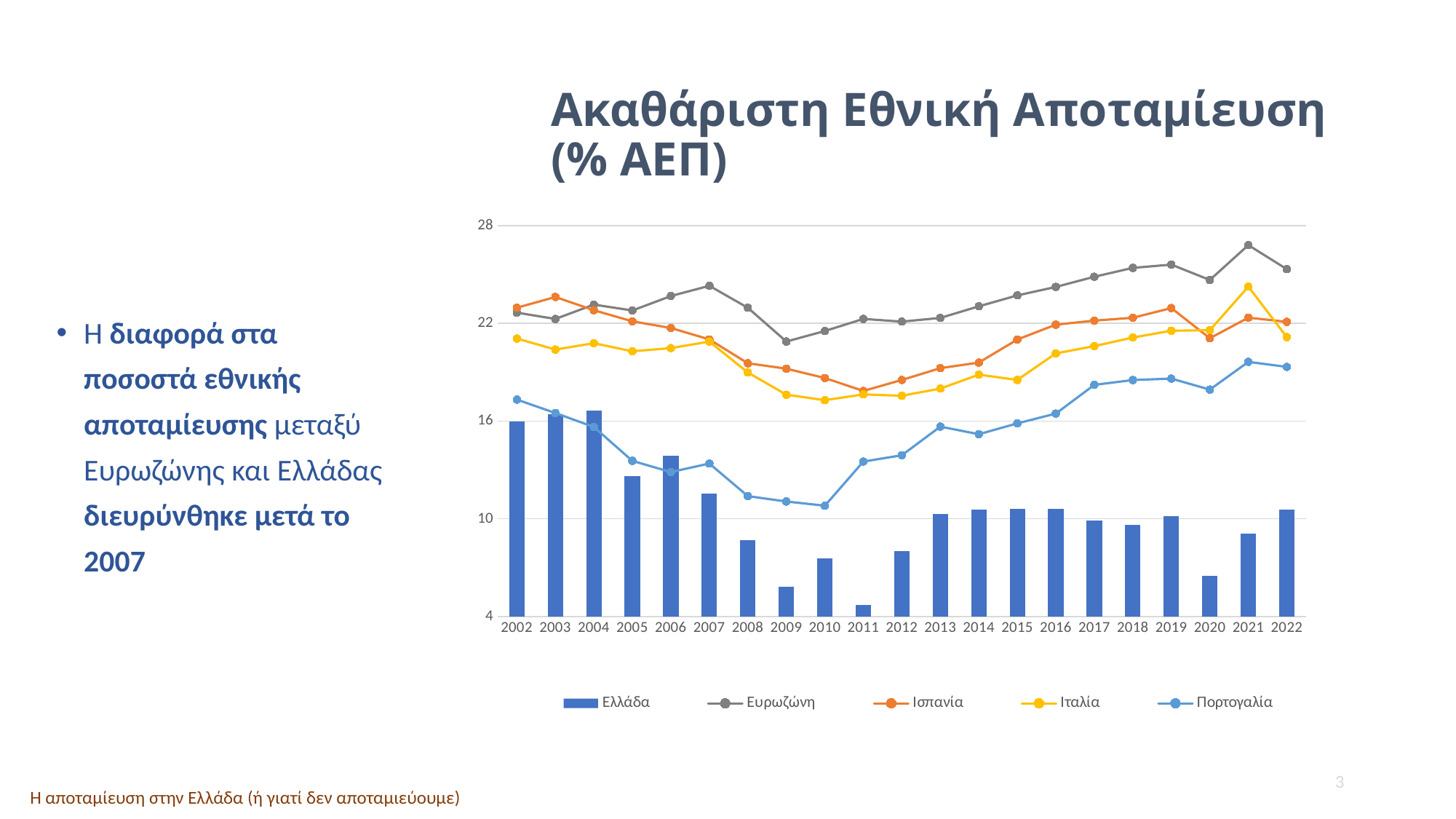
In which year is the value for Ελλάδα lowest? 2011 In which year is the value for Ευρωζώνη highest? 2021 Is the value for Ελλάδα in 2011 greater or less than 10? less What kind of chart is this? Bar and line chart How many series does the legend list? 5 In which year is the value for Ιταλία highest? 2021 Which is larger in 2010, Ισπανία or Ιταλία? Ισπανία In which year is the value for Ευρωζώνη lowest? 2009 How many years are shown on the x axis? 21 What is the title of the chart? Ακαθάριστη Εθνική Αποταμίευση (% ΑΕΠ) Is the value for Ευρωζώνη in 2021 greater or less than 22? greater Do the values for Ελλάδα rise or fall from 2004 to 2011? fall